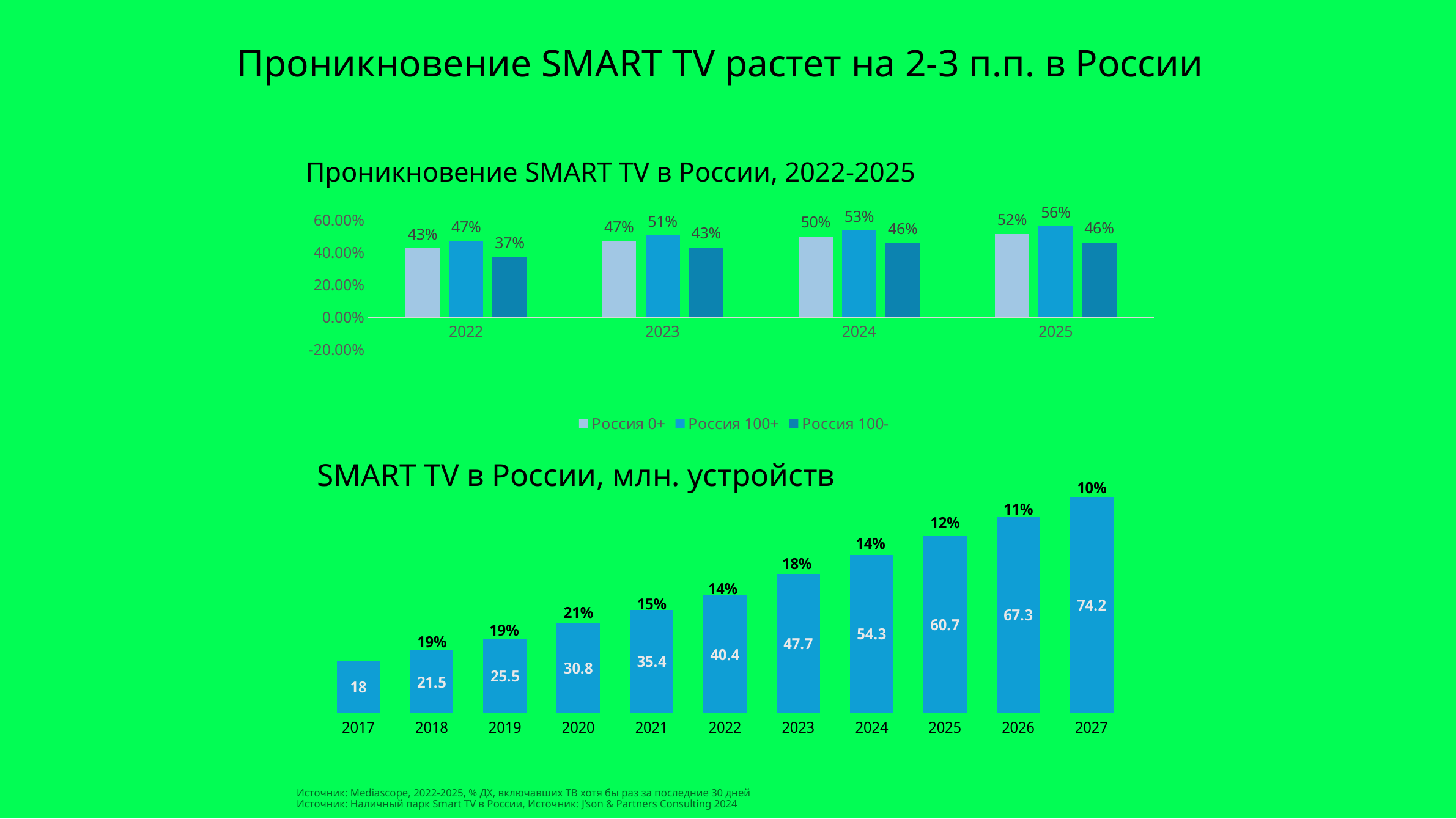
In the chart 'Проникновение SMART TV в России, 2022-2025', does the value for Россия 0+ rise or fall from 2022 to 2025? rise In the chart 'Проникновение SMART TV в России, 2022-2025', how many series does the legend list? 3 What kind of chart is 'SMART TV в России, млн. устройств'? bar chart In the chart 'SMART TV в России, млн. устройств', what is the value for 2023? 47.7 In the chart 'SMART TV в России, млн. устройств', how many years are shown on the x axis? 11 In the chart 'SMART TV в России, млн. устройств', what is the difference between the values for 2027 and 2017? 56.2 In the chart 'Проникновение SMART TV в России, 2022-2025', what is the value for Россия 100+ in 2025? 56% In the chart 'Проникновение SMART TV в России, 2022-2025', what is the difference between Россия 100+ and Россия 100- in 2024? 7 percentage points In the chart 'SMART TV в России, млн. устройств', what growth percentage is shown above the 2020 bar? 21% In the chart 'Проникновение SMART TV в России, 2022-2025', which series has the highest value in 2023? Россия 100+ In the chart 'SMART TV в России, млн. устройств', which year has the lowest value? 2017 In the chart 'Проникновение SMART TV в России, 2022-2025', what is the value for Россия 100- in 2022? 37%